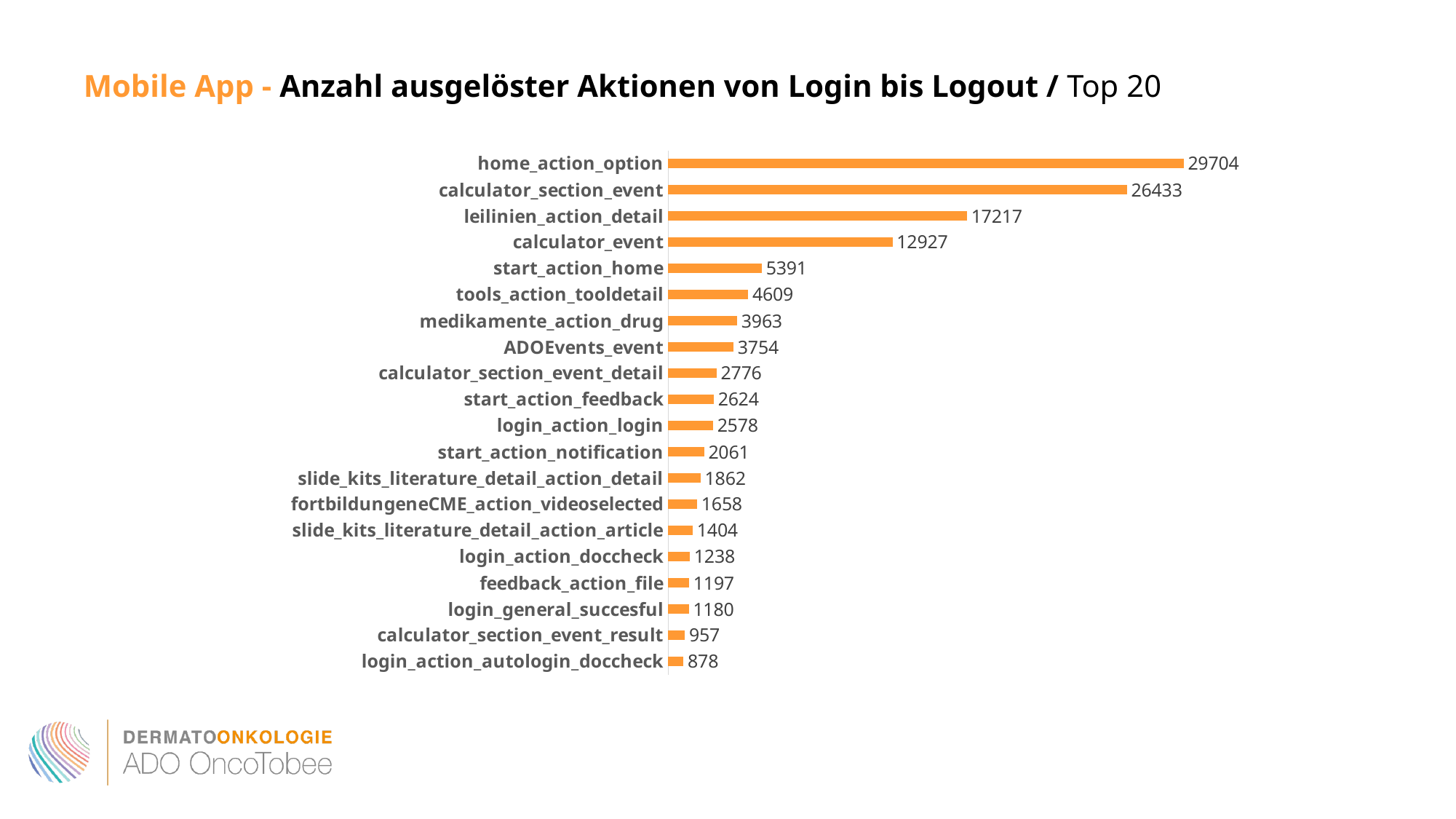
How many categories are shown in the chart? 20 What is the difference between leilinien_action_detail and calculator_event? 4290 What is the value for feedback_action_file? 1197 Which category has the highest value? home_action_option Which is larger, start_action_home or tools_action_tooldetail? start_action_home What is the value for home_action_option? 29704 What kind of chart is shown on the slide? bar chart What is the difference between home_action_option and calculator_section_event? 3271 What is the value for login_action_login? 2578 What is the value for calculator_event? 12927 Which category has the lowest value? login_action_autologin_doccheck What colour are the bars in the chart? orange